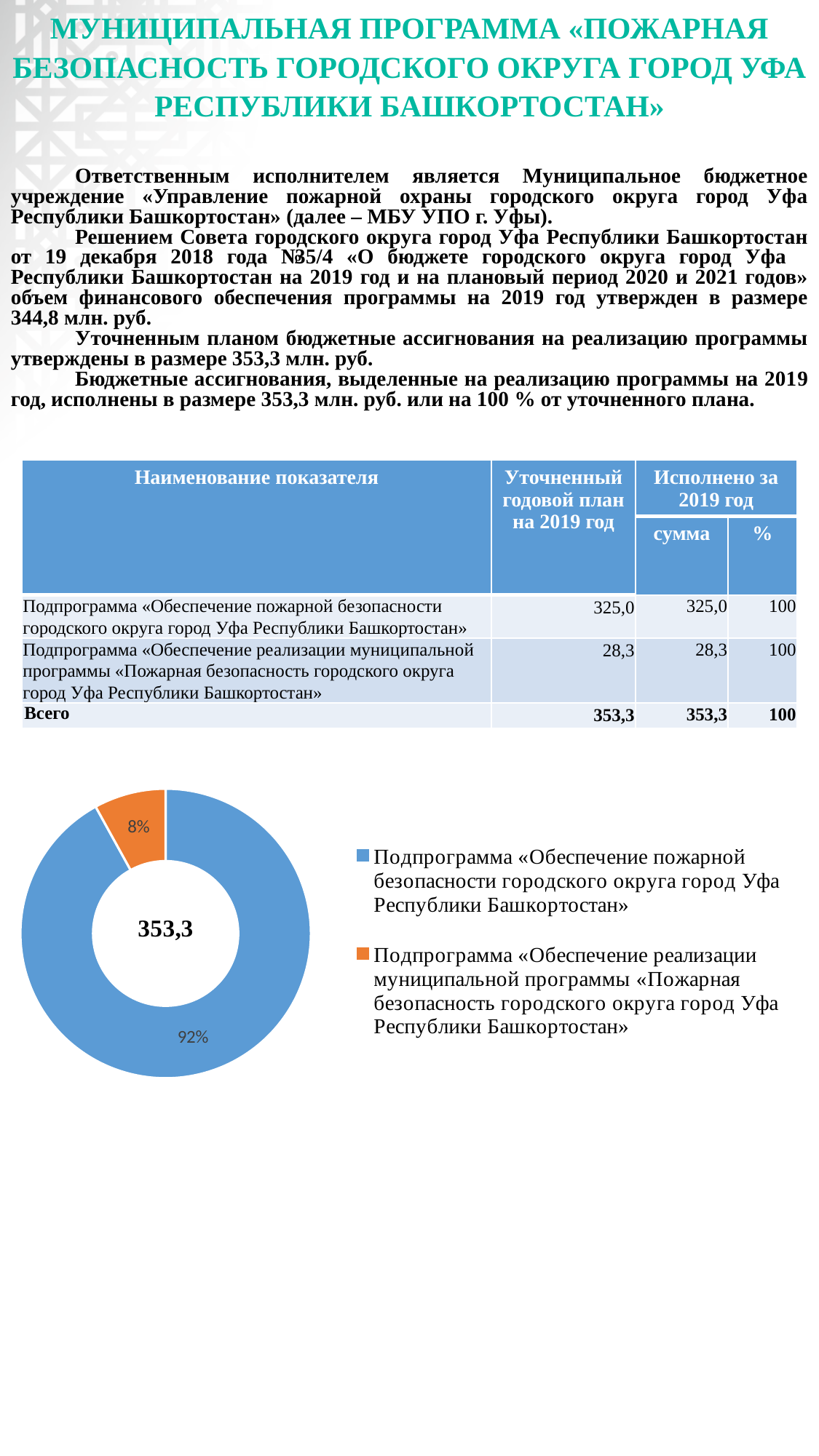
What share of the doughnut chart does the slice for «Подпрограмма «Обеспечение реализации муниципальной программы «Пожарная безопасность городского округа город Уфа Республики Башкортостан»» take? 8% Which slice of the doughnut chart is the largest? Подпрограмма «Обеспечение пожарной безопасности городского округа город Уфа Республики Башкортостан» Which slice of the doughnut chart is the smallest? Подпрограмма «Обеспечение реализации муниципальной программы «Пожарная безопасность городского округа город Уфа Республики Башкортостан» What share of the doughnut chart does the slice for «Подпрограмма «Обеспечение пожарной безопасности городского округа город Уфа Республики Башкортостан»» take? 92% How many slices does the doughnut chart have? 2 How many entries does the legend of the doughnut chart list? 2 By how many percentage points does the 92% slice exceed the 8% slice in the doughnut chart? 84 percentage points In the doughnut chart, which is larger: the blue slice or the orange slice? The blue slice What kind of chart is shown on the slide? Doughnut chart What colour is the slice for «Подпрограмма «Обеспечение реализации муниципальной программы «Пожарная безопасность городского округа город Уфа Республики Башкортостан»» in the doughnut chart? Orange What value is printed in the centre of the doughnut chart? 353,3